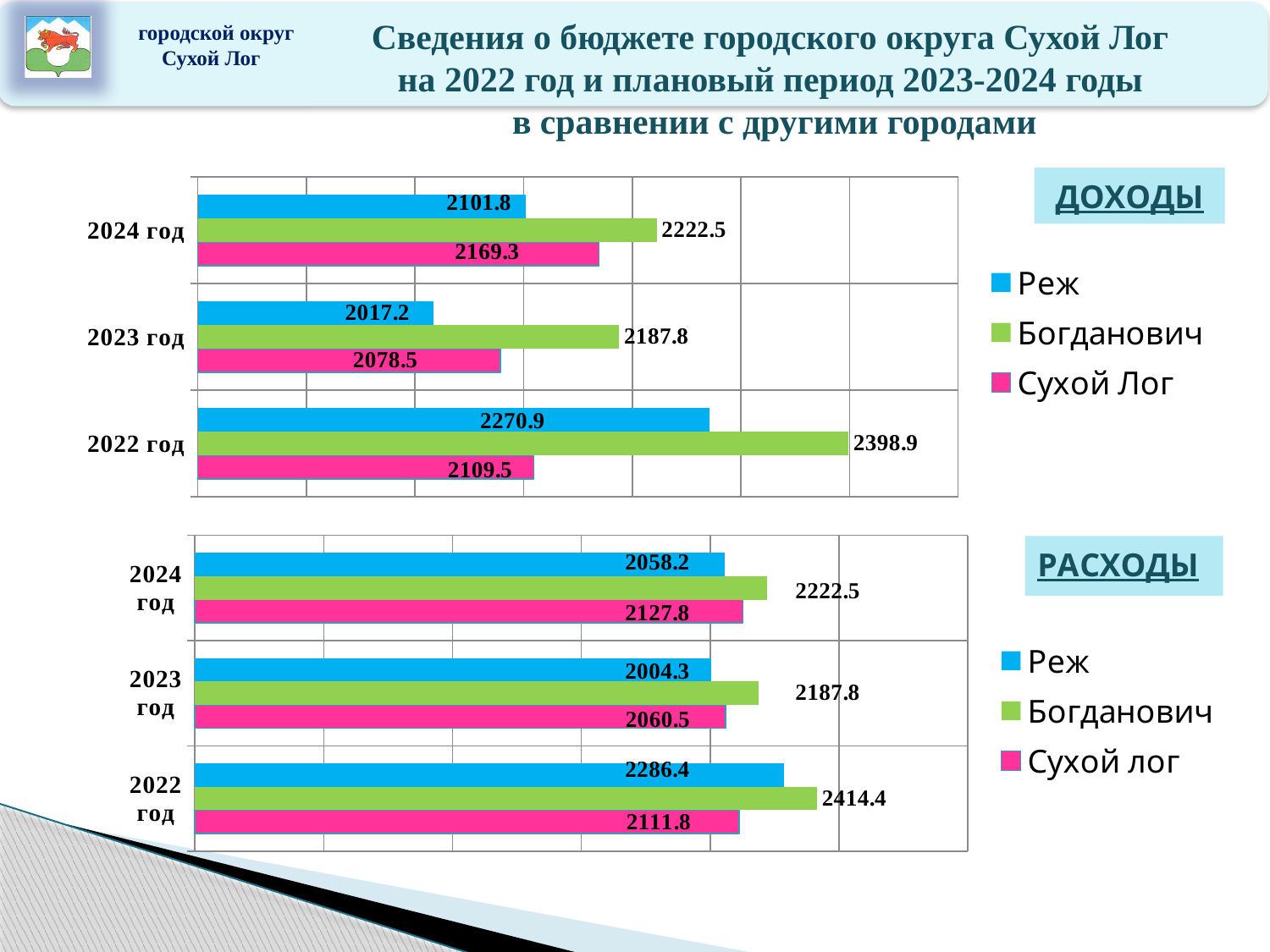
What type of chart is the РАСХОДЫ chart? Bar chart In the ДОХОДЫ chart, what is the value for Богданович in 2022 год? 2398.9 In the ДОХОДЫ chart, which city has the highest value in 2024 год? Богданович In the РАСХОДЫ chart, which city has the lowest value in 2023 год? Реж In the ДОХОДЫ chart, what is the value for Сухой Лог in 2023 год? 2078.5 In the РАСХОДЫ chart, what is the value for Реж in 2024 год? 2058.2 How many series does the legend of the РАСХОДЫ chart list? 3 In the РАСХОДЫ chart, what is the value for Сухой лог in 2022 год? 2111.8 In the ДОХОДЫ chart, which is larger in 2022 год: Реж or Сухой Лог? Реж How many year categories are shown in the ДОХОДЫ chart? 3 In the ДОХОДЫ chart, what is the difference between Богданович and Реж in 2023 год? 170.6 In the РАСХОДЫ chart, what is the difference between Богданович and Сухой лог in 2022 год? 302.6